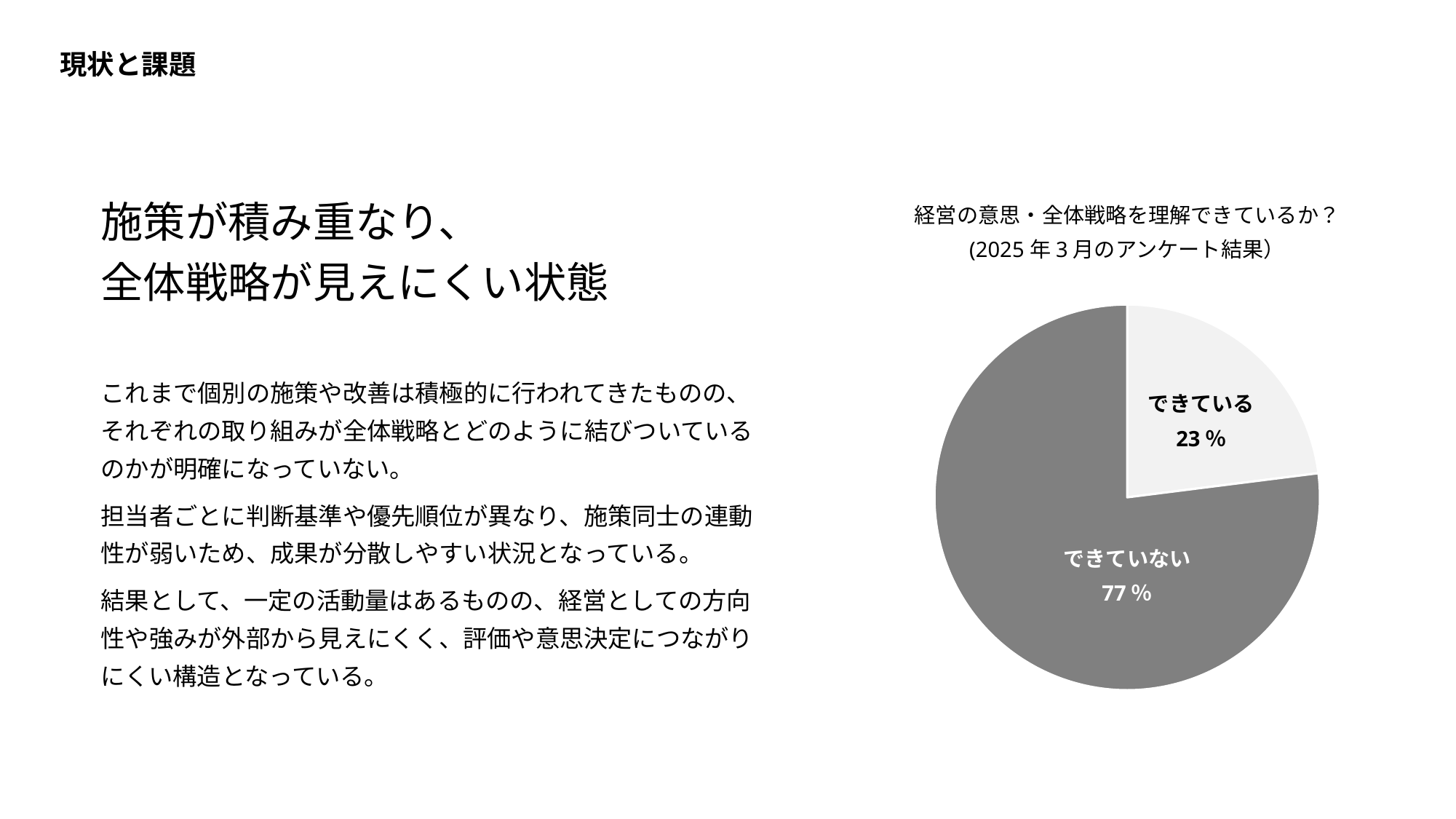
What is the title of the chart? 経営の意思・全体戦略を理解できているか？ What is the difference between the できていない and できている values? 54 % Which category has the smallest share of the pie? できている How many slices does the pie chart have? 2 According to the chart subtitle, when was the survey conducted? 2025 年 3 月 Which category has the largest share of the pie? できていない What kind of chart is shown on the slide? Pie chart What share of the pie does できている represent? 23 % Which is larger, できている or できていない? できていない What is the value for できていない? 77 % What is the value for できている? 23 %